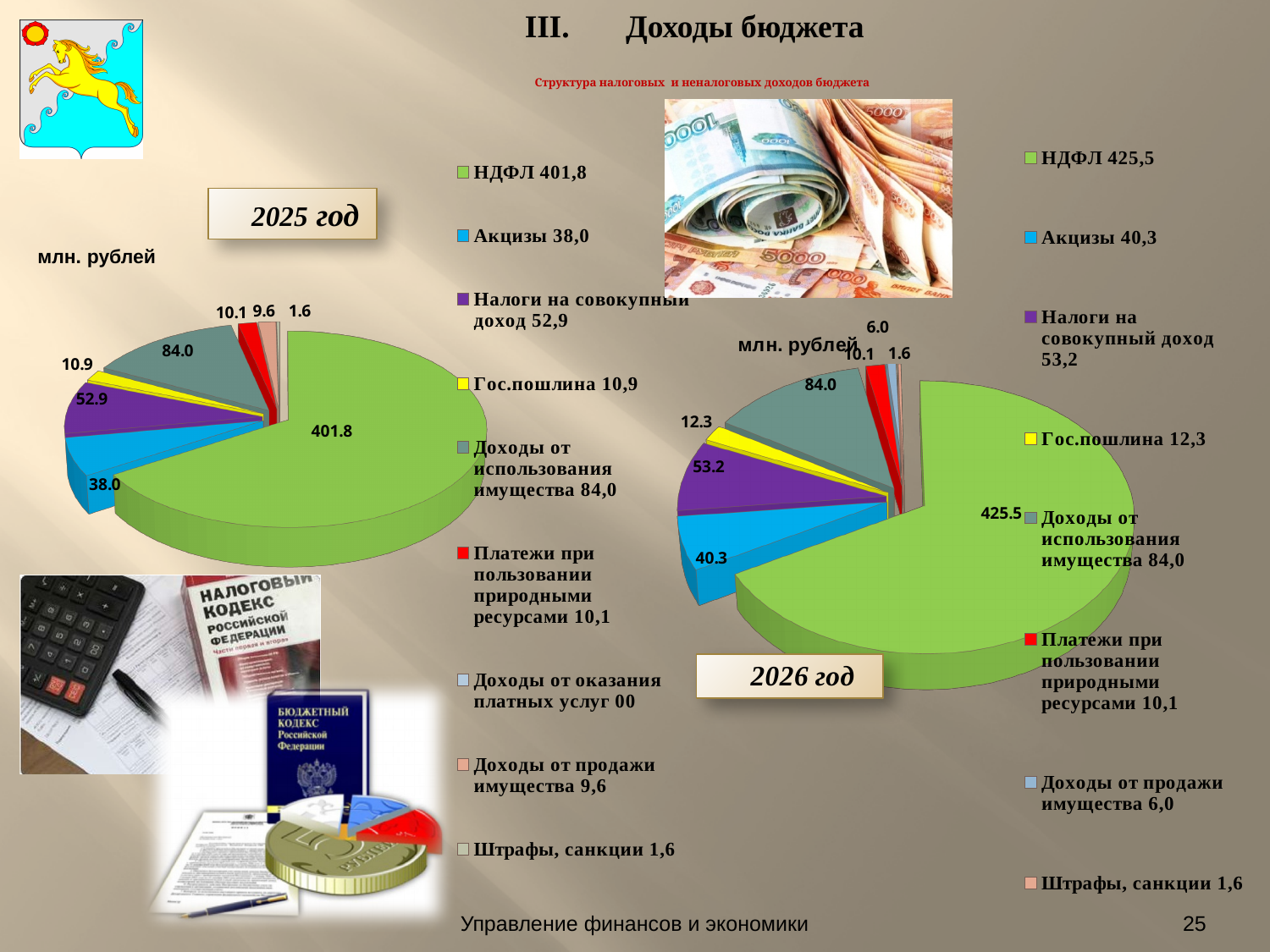
In the 2026 год chart, which category has the smallest value? Штрафы, санкции In the 2025 год chart, what is the value for НДФЛ? 401.8 How many entries does the legend of the 2025 год chart list? 9 In the 2025 год chart, which is larger: Налоги на совокупный доход or Акцизы? Налоги на совокупный доход In the 2026 год chart, what is the value for Акцизы? 40.3 How many entries does the legend of the 2026 год chart list? 8 What type of chart is used for the 2025 год chart? pie chart In the 2025 год chart, what is the difference between Доходы от использования имущества and Акцизы? 46.0 In the 2026 год chart, which category has the largest value? НДФЛ In the 2026 год chart, what is the value for Гос.пошлина? 12.3 In the 2025 год chart, what is the value for Доходы от продажи имущества? 9.6 What is the difference between the НДФЛ value in the 2026 год chart and the НДФЛ value in the 2025 год chart? 23.7